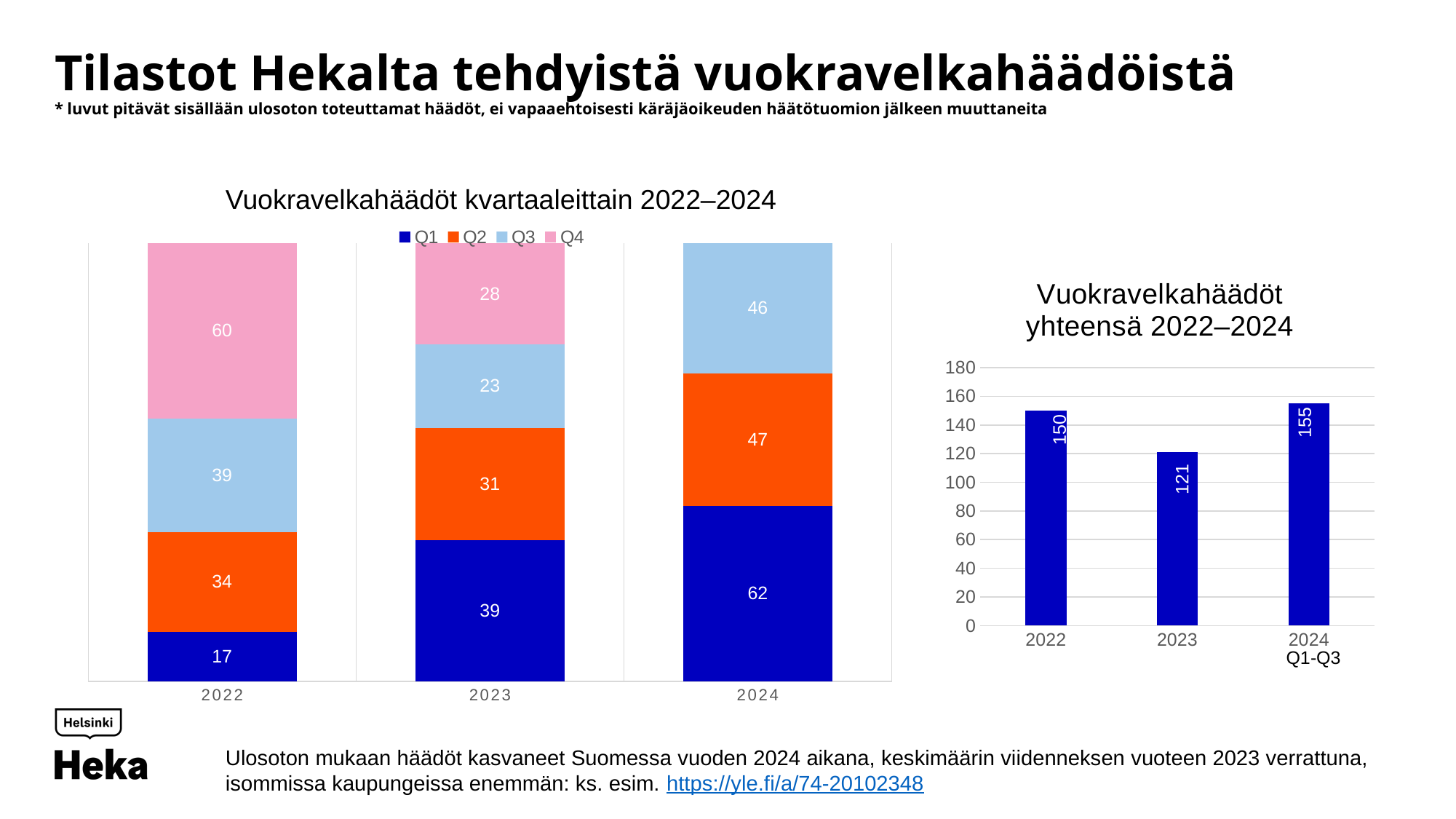
In the chart 'Vuokravelkahäädöt kvartaaleittain 2022–2024', what is the Q1 value for 2024? 62 In the chart 'Vuokravelkahäädöt kvartaaleittain 2022–2024', what is the difference between the Q1 values for 2024 and 2022? 45 In the chart 'Vuokravelkahäädöt kvartaaleittain 2022–2024', what is the Q4 value for 2022? 60 In the chart 'Vuokravelkahäädöt kvartaaleittain 2022–2024', which is larger: the Q2 value for 2022 or the Q2 value for 2023? 2022 In the chart 'Vuokravelkahäädöt yhteensä 2022–2024', which year has the lowest value? 2023 What kind of chart is 'Vuokravelkahäädöt yhteensä 2022–2024'? Bar chart In the chart 'Vuokravelkahäädöt yhteensä 2022–2024', what is the value for 2023? 121 In the chart 'Vuokravelkahäädöt kvartaaleittain 2022–2024', what is the total of the stacked bar for 2023? 121 In the chart 'Vuokravelkahäädöt yhteensä 2022–2024', which year has the highest value? 2024 Q1-Q3 In the chart 'Vuokravelkahäädöt yhteensä 2022–2024', what is the difference between the values for 2024 Q1-Q3 and 2022? 5 In the chart 'Vuokravelkahäädöt kvartaaleittain 2022–2024', what is the Q3 value for 2023? 23 In the chart 'Vuokravelkahäädöt kvartaaleittain 2022–2024', how many series does the legend list? 4